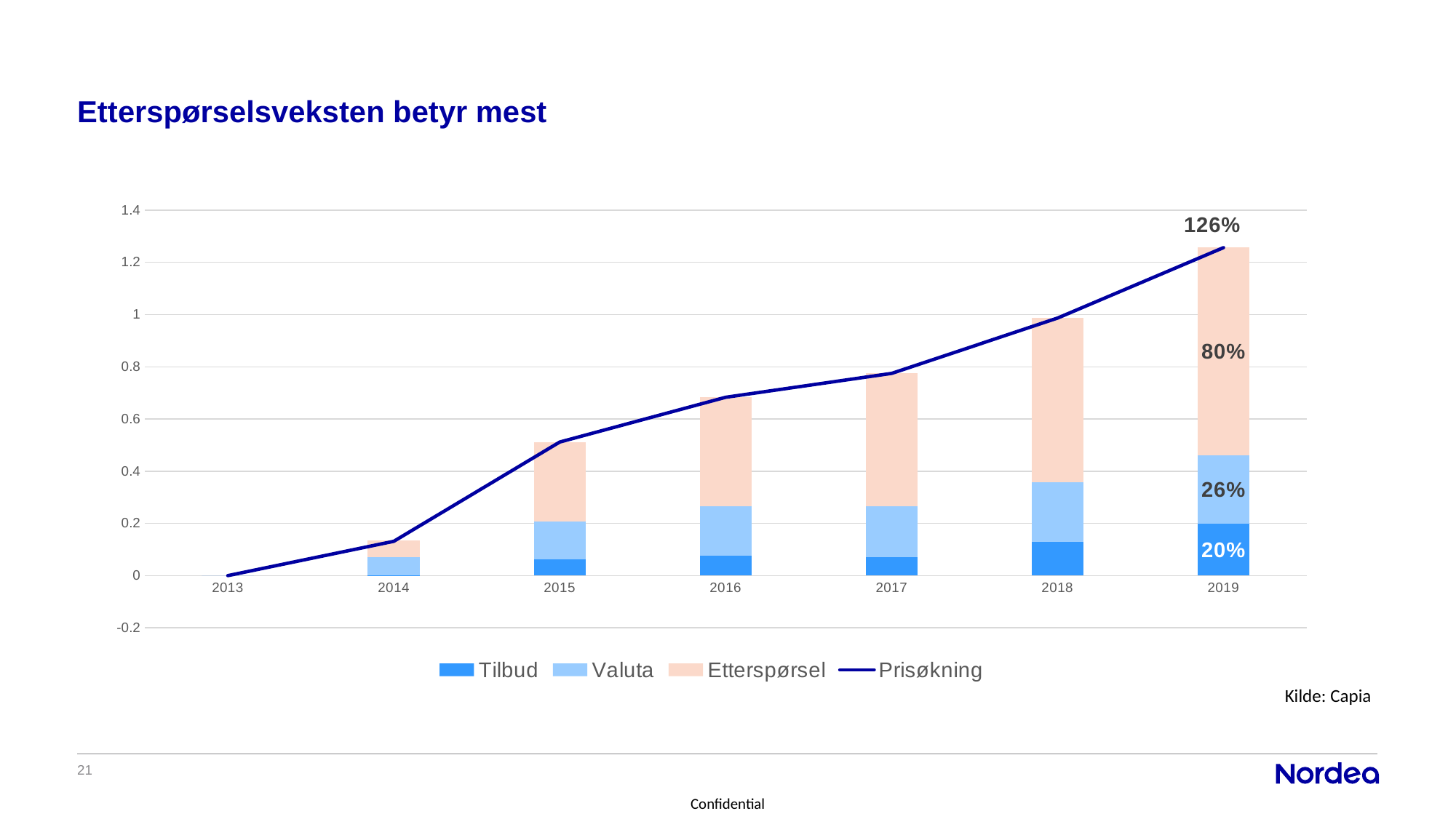
Is the Prisøkning value for 2016 greater or less than 0.6? greater How many series does the legend list? 4 In which year is the Prisøkning line highest? 2019 What kind of chart is this? Stacked bar chart with a line What is the difference between the Etterspørsel and Valuta labels for 2019? 54% How many years are shown on the x axis? 7 Does the Prisøkning line rise or fall from 2013 to 2019? Rises What is the Etterspørsel value labelled for 2019? 80% What is the Tilbud value labelled for 2019? 20% What is the Prisøkning value shown for 2019? 126% What is the title of the chart slide? Etterspørselsveksten betyr mest What is the Valuta value labelled for 2019? 26%